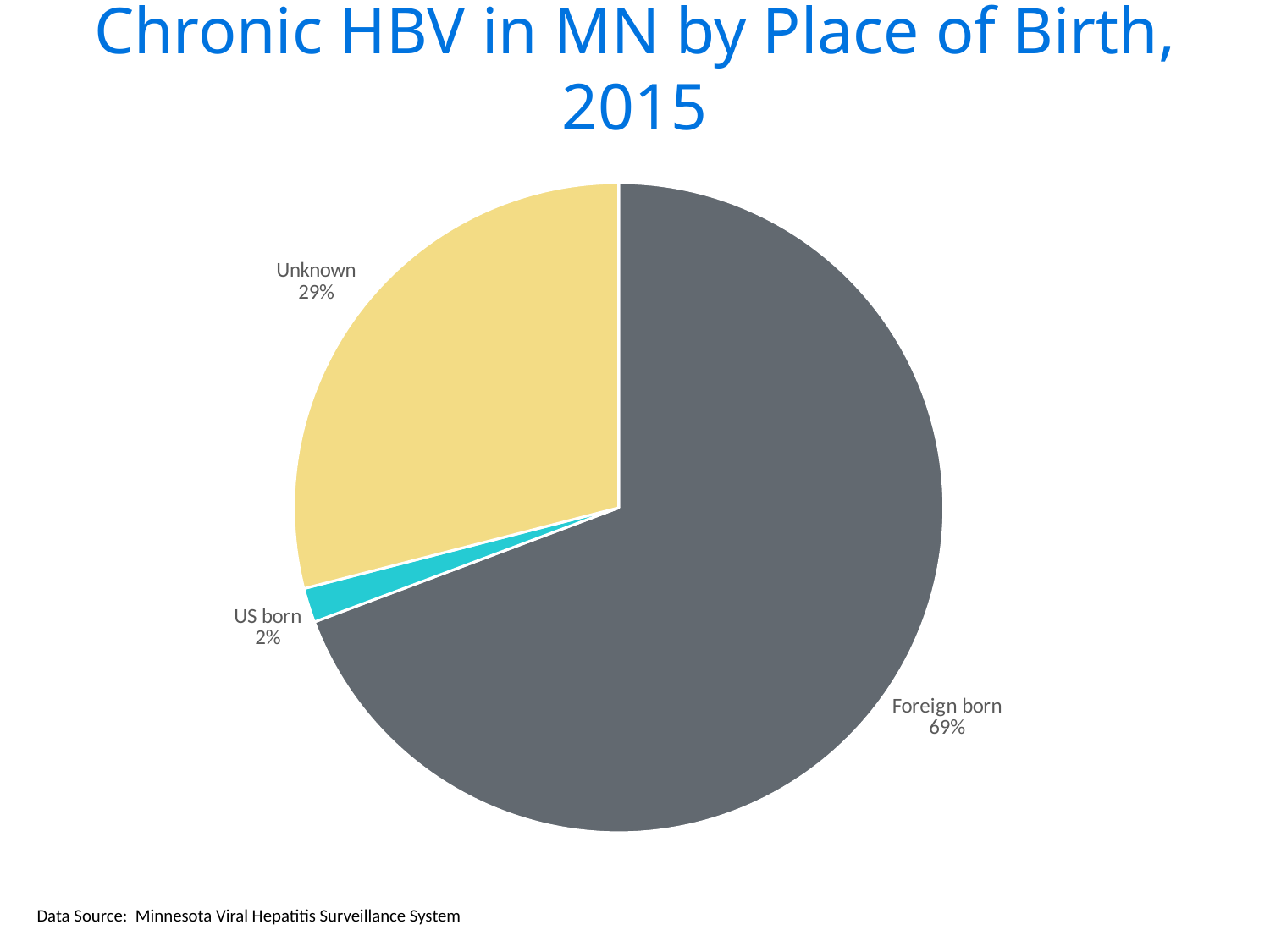
What is the title of the chart? Chronic HBV in MN by Place of Birth, 2015 What share of chronic HBV cases is labelled Foreign born? 69% What is the difference in percentage points between the Foreign born and Unknown slices? 40 Which place-of-birth category has the largest slice? Foreign born What data source is cited on the slide? Minnesota Viral Hepatitis Surveillance System What share of chronic HBV cases is labelled Unknown? 29% Which is larger, the Unknown slice or the US born slice? Unknown What is the difference in percentage points between the Unknown and US born slices? 27 Which place-of-birth category has the smallest slice? US born What share of chronic HBV cases is labelled US born? 2% How many slices does the pie chart have? 3 What type of chart is shown on the slide? pie chart